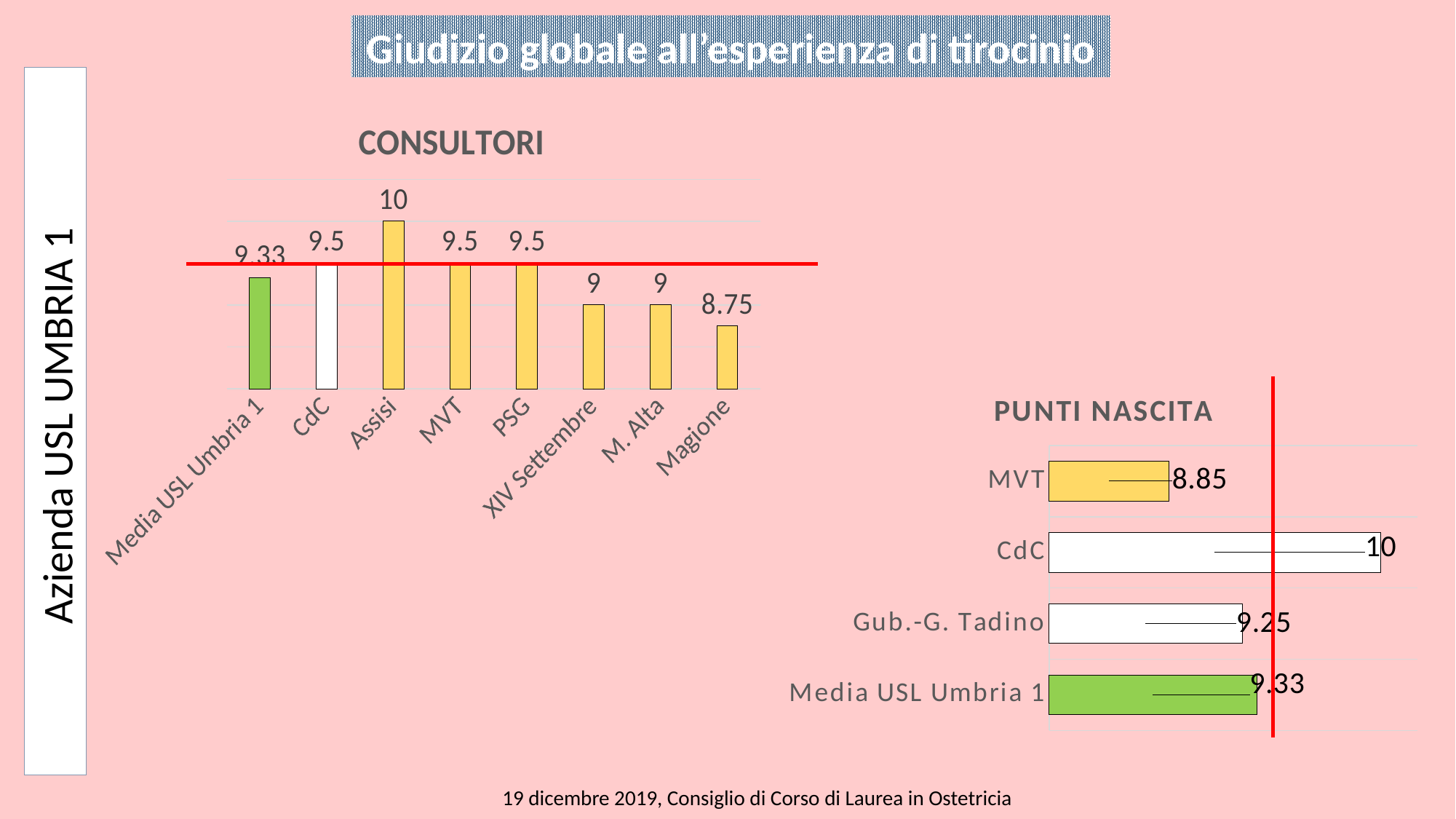
In the CONSULTORI chart, what is the value for Magione? 8.75 In the PUNTI NASCITA chart, which is larger, the value for Gub.-G. Tadino or the value for Media USL Umbria 1? Media USL Umbria 1 In the CONSULTORI chart, what is the value for Assisi? 10 In the PUNTI NASCITA chart, what is the difference between the values for CdC and MVT? 1.15 In the CONSULTORI chart, which category has the lowest value? Magione In the CONSULTORI chart, what is the difference between the values for Assisi and Magione? 1.25 In the PUNTI NASCITA chart, what is the value for MVT? 8.85 What kind of chart is the PUNTI NASCITA chart? Bar chart In the CONSULTORI chart, how many categories are shown? 8 In the CONSULTORI chart, which category has the highest value? Assisi In the PUNTI NASCITA chart, which category has the highest value? CdC In the PUNTI NASCITA chart, what is the value for Gub.-G. Tadino? 9.25